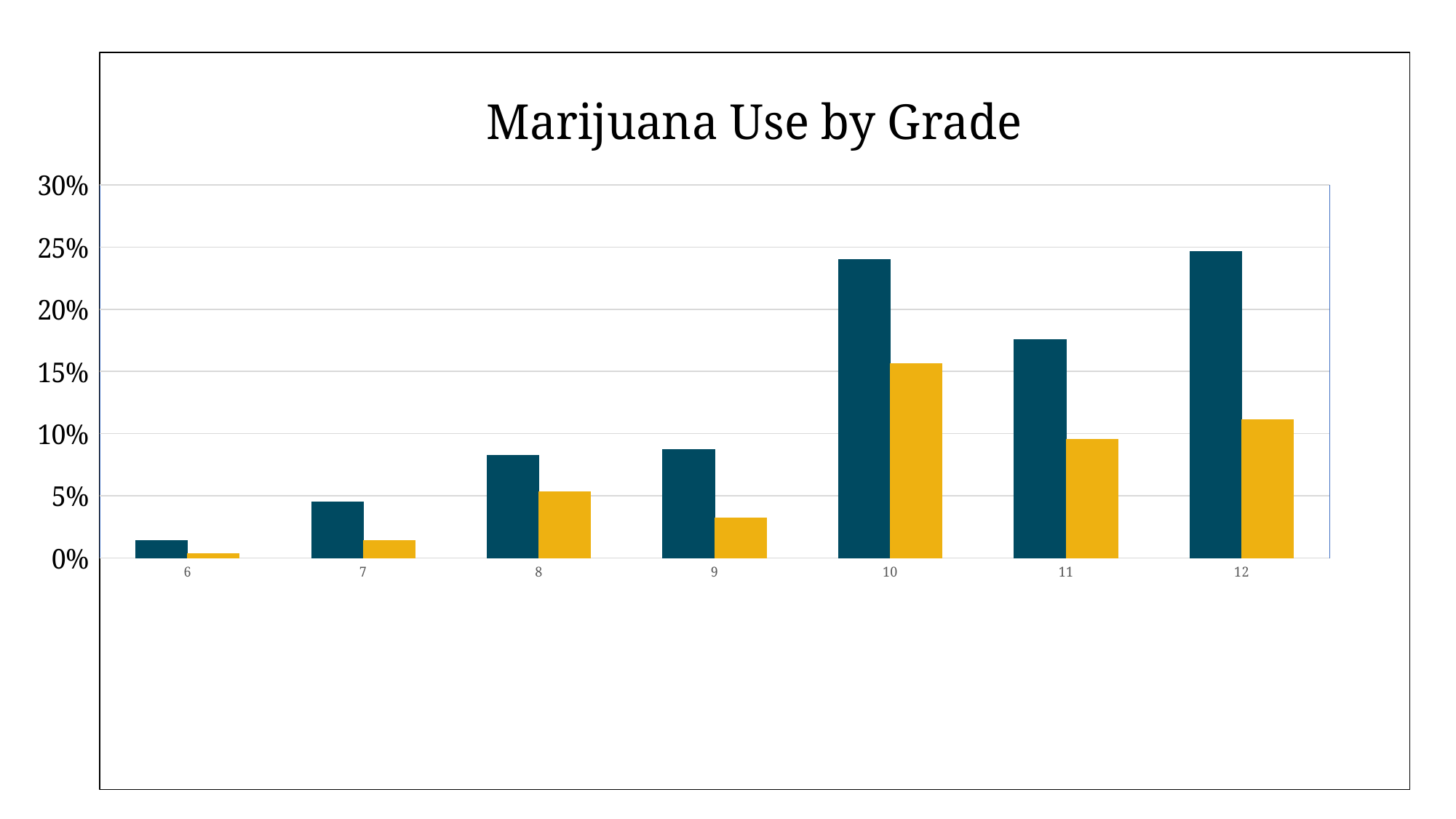
Is the yellow value for grade 9 greater or less than 5%? less How many data series (bar colours) are plotted for each grade? 2 Which grade has the lowest dark blue bar? 6 Is the dark blue value for grade 10 greater or less than 20%? greater Is the dark blue value for grade 7 greater or less than 5%? less Which is larger, the dark blue bar for grade 10 or the dark blue bar for grade 11? grade 10 What kind of chart is shown on the slide? bar chart How many grade categories are shown on the x axis? 7 What is the title of the chart? Marijuana Use by Grade Do the dark blue bars rise or fall from grade 6 to grade 10? rise Which grade has the highest yellow bar? 10